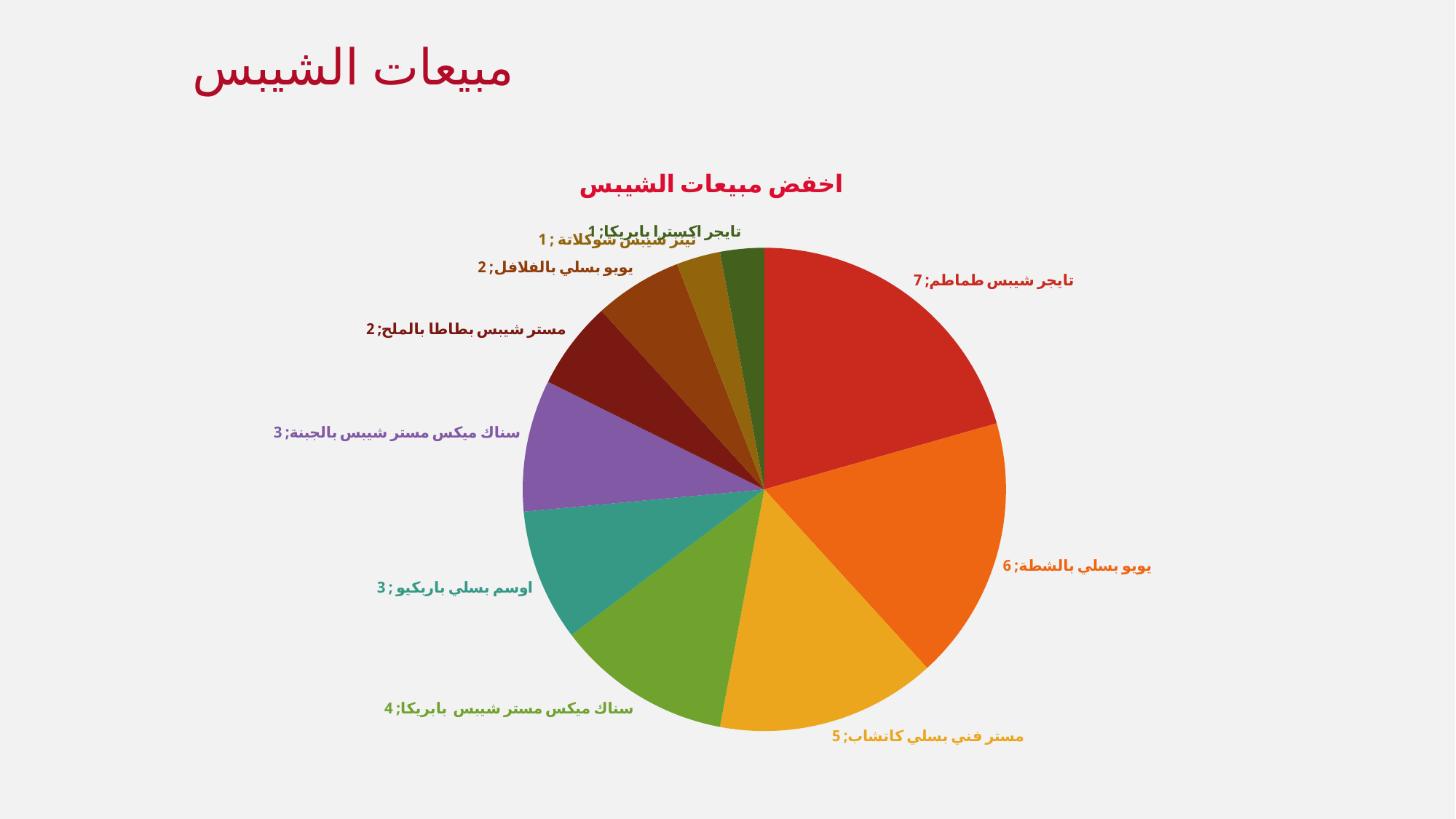
What is the value for تايجر شيبس طماطم? 7 What is the value for مستر شيبس بطاطا بالملح? 2 What is the difference between the values for تايجر شيبس طماطم and يويو بسلي بالشطة? 1 What is the value for سناك ميكس مستر شيبس بابريكا? 4 What kind of chart is shown on the slide? pie chart What is the value for يويو بسلي بالشطة? 6 How many slices does the pie chart have? 10 What is the title of the chart? اخفض مبيعات الشيبس What is the difference between the values for مستر فني بسلي كاتشاب and يويو بسلي بالفلافل? 3 What is the value for مستر فني بسلي كاتشاب? 5 Which category has the largest slice of the pie? تايجر شيبس طماطم Which is larger, the value for سناك ميكس مستر شيبس بابريكا or the value for اوسم بسلي باربكيو? سناك ميكس مستر شيبس بابريكا